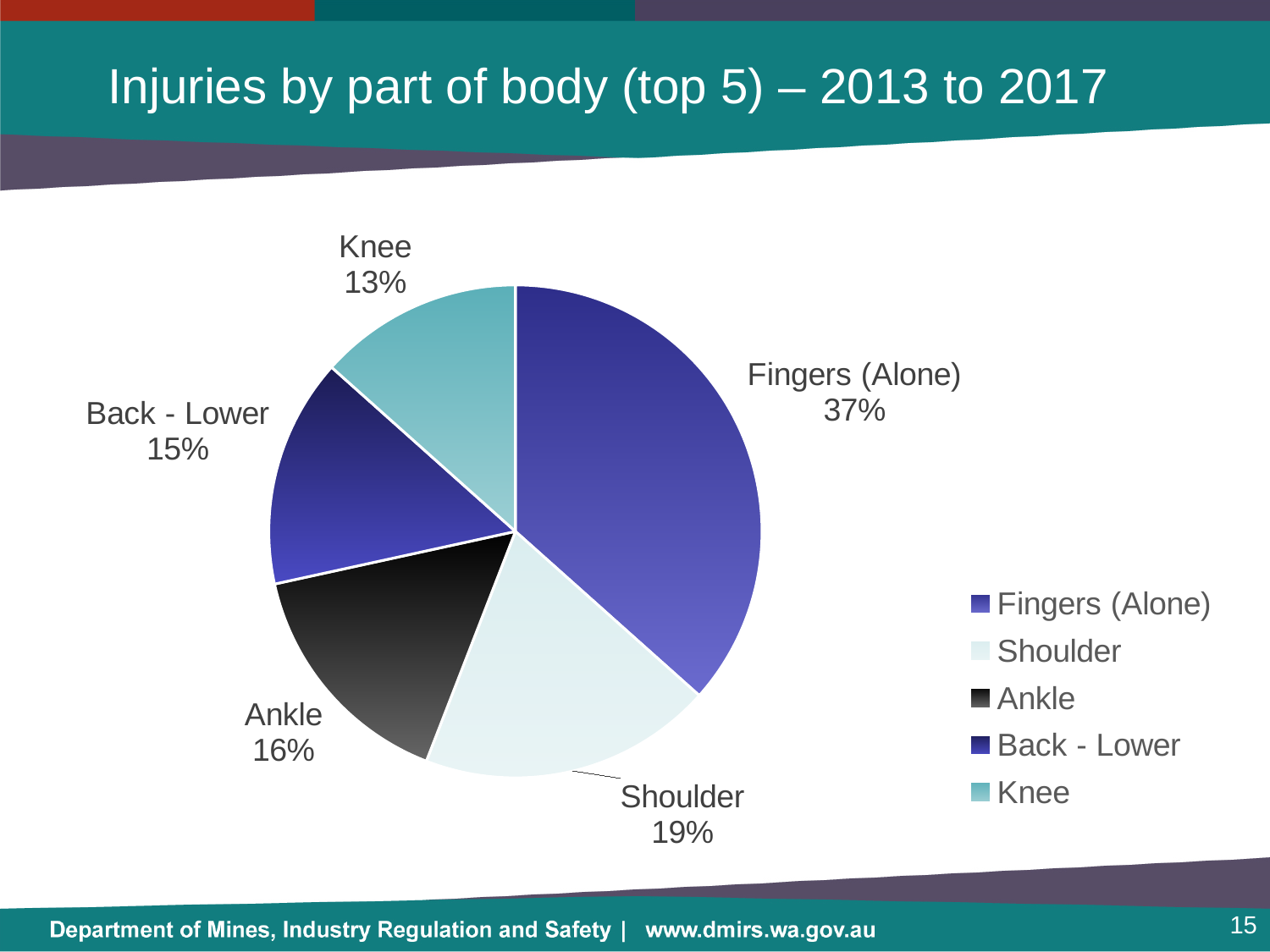
Which has a larger share of injuries, Back - Lower or Shoulder? Shoulder What is the title of the chart? Injuries by part of body (top 5) – 2013 to 2017 How many parts of body are shown in the pie chart? 5 What is the difference in percentage points between Ankle and Knee? 3 What type of chart is shown on the slide? Pie chart What percentage of injuries is attributed to Shoulder? 19% What percentage of injuries is attributed to Fingers (Alone)? 37% Which legend entry is shown in black? Ankle Which part of body has the smallest share of injuries? Knee What is the difference in percentage points between Fingers (Alone) and Shoulder? 18 What percentage of injuries is attributed to Knee? 13% Which part of body has the largest share of injuries? Fingers (Alone)